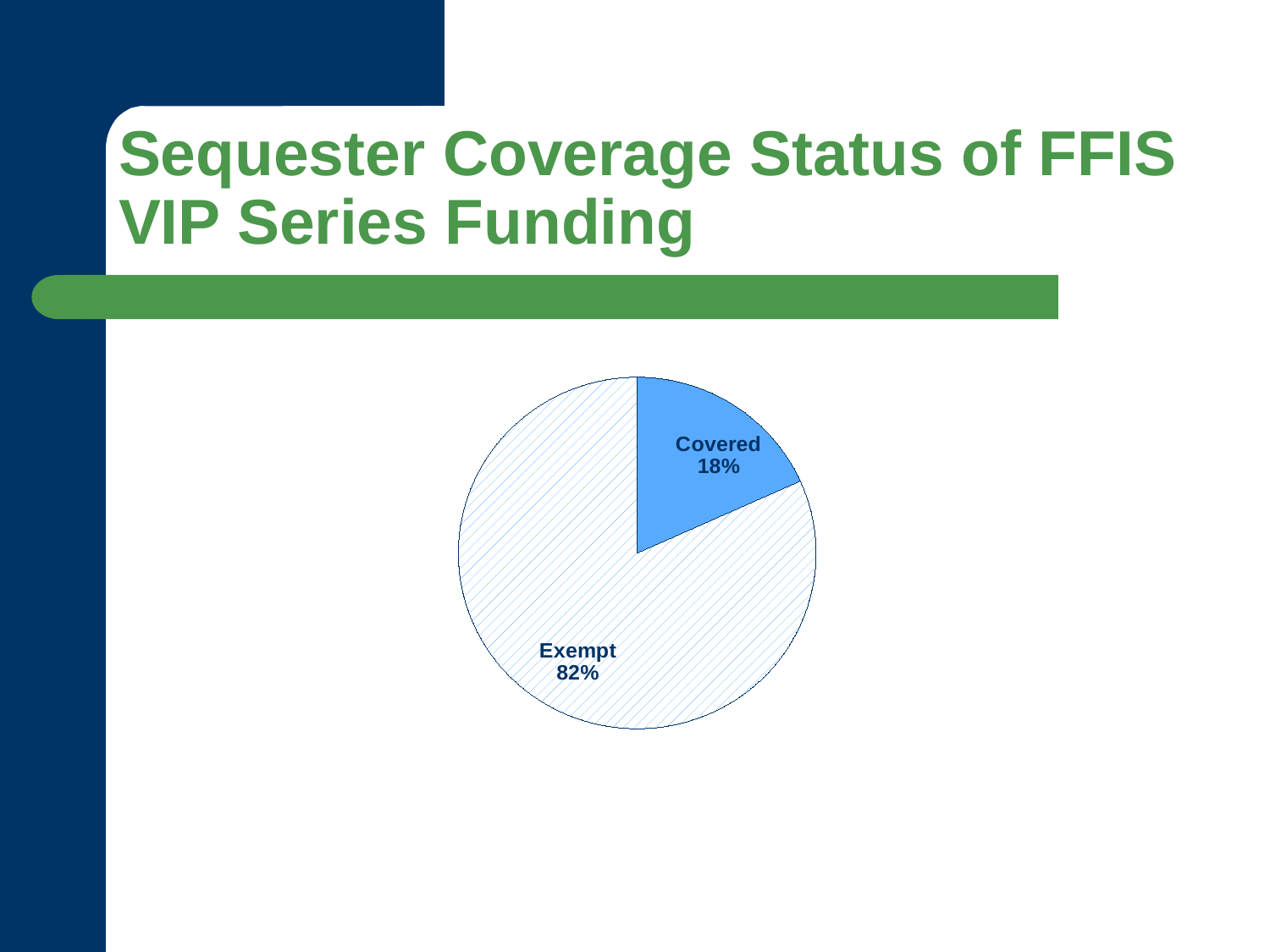
Which slice of the pie is the largest? Exempt Is the Covered share greater or less than 25%? less How many slices does the pie chart have? 2 Is the Exempt share greater or less than 75%? greater What is the difference in percentage points between the Exempt and Covered slices? 64 Which slice of the pie is filled with solid blue? Covered Which is larger, the Covered slice or the Exempt slice? Exempt What kind of chart is shown on the slide? pie chart What is the title of the slide containing the pie chart? Sequester Coverage Status of FFIS VIP Series Funding Which slice of the pie is the smallest? Covered What share of the pie is labelled Covered? 18% What share of the pie is labelled Exempt? 82%